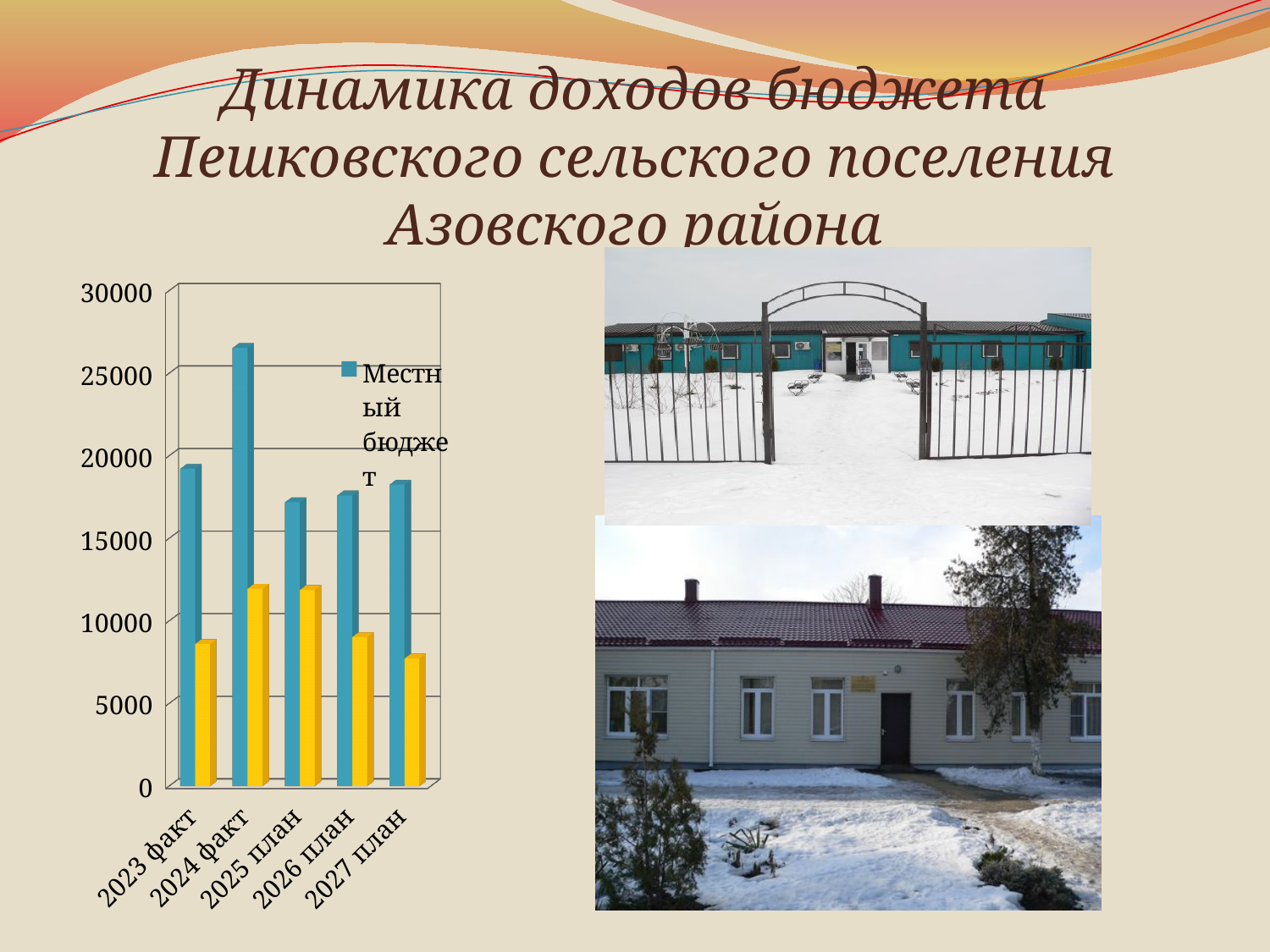
Is the Местный бюджет value for 2023 факт greater or less than 20000? less Which is larger for the Местный бюджет series: 2023 факт or 2024 факт? 2024 факт Which yellow bar is larger: 2024 факт or 2027 план? 2024 факт Which category has the highest value for the Местный бюджет series? 2024 факт Is the yellow bar for 2023 факт greater or less than 10000? less What kind of chart is shown on the slide? bar chart Is the Местный бюджет value for 2025 план greater or less than 15000? greater How many categories are shown on the x axis of the chart? 5 What series name is shown in the chart legend? Местный бюджет